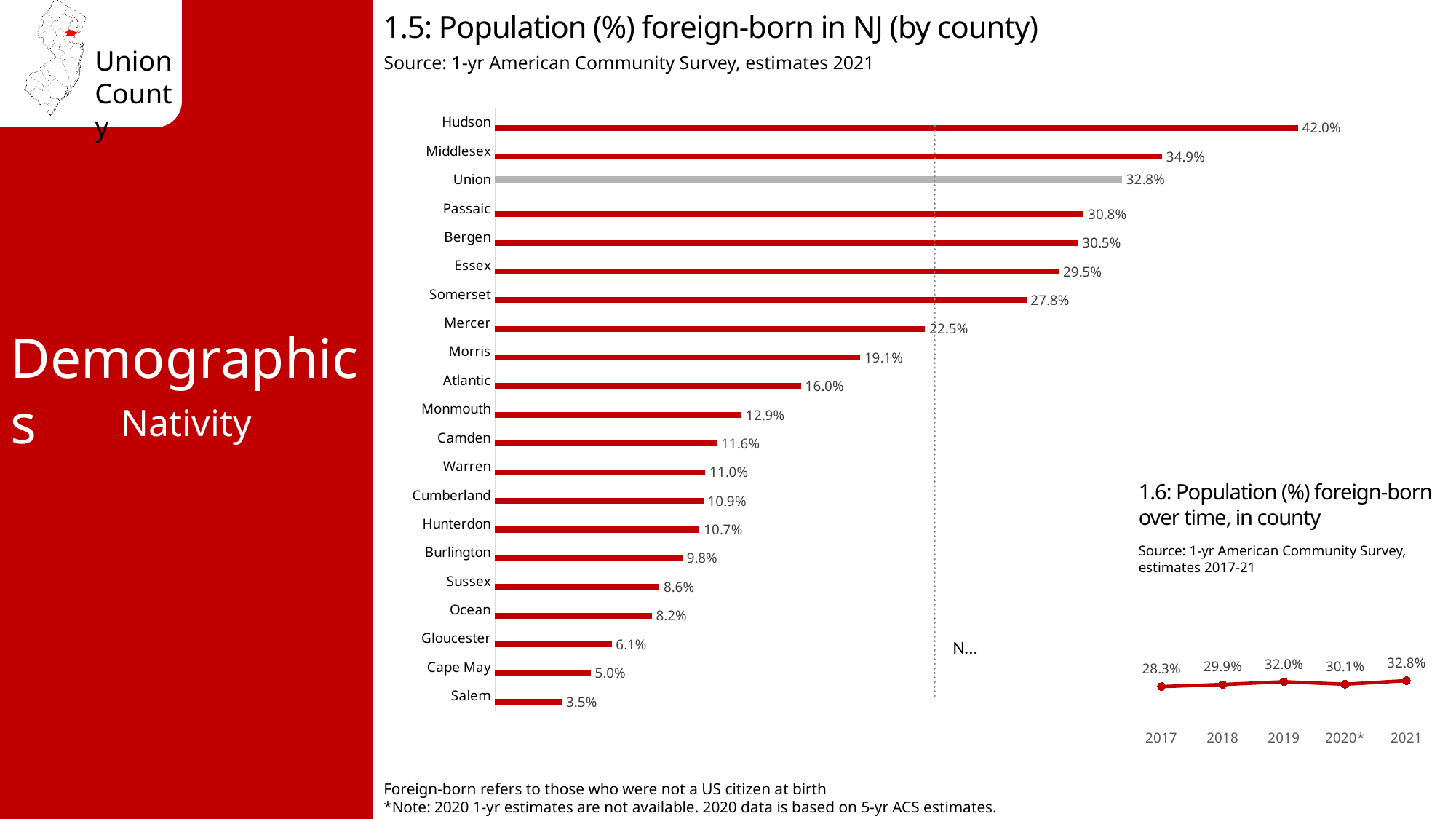
In the chart '1.5: Population (%) foreign-born in NJ (by county)', what is the value for Union? 32.8% In the chart '1.5: Population (%) foreign-born in NJ (by county)', which county has the highest value? Hudson In the chart '1.5: Population (%) foreign-born in NJ (by county)', what is the difference between Hudson and Middlesex? 7.1% What kind of chart is '1.6: Population (%) foreign-born over time, in county'? Line chart In the chart '1.5: Population (%) foreign-born in NJ (by county)', what is the value for Mercer? 22.5% In the chart '1.5: Population (%) foreign-born in NJ (by county)', which is larger, Passaic or Bergen? Passaic What kind of chart is '1.5: Population (%) foreign-born in NJ (by county)'? Bar chart In the chart '1.5: Population (%) foreign-born in NJ (by county)', which county has the lowest value? Salem In the chart '1.6: Population (%) foreign-born over time, in county', which year has the lowest value? 2017 In the chart '1.6: Population (%) foreign-born over time, in county', what is the difference between 2021 and 2017? 4.5% In the chart '1.6: Population (%) foreign-born over time, in county', what is the value for 2019? 32.0% In the chart '1.5: Population (%) foreign-born in NJ (by county)', how many counties are shown? 21